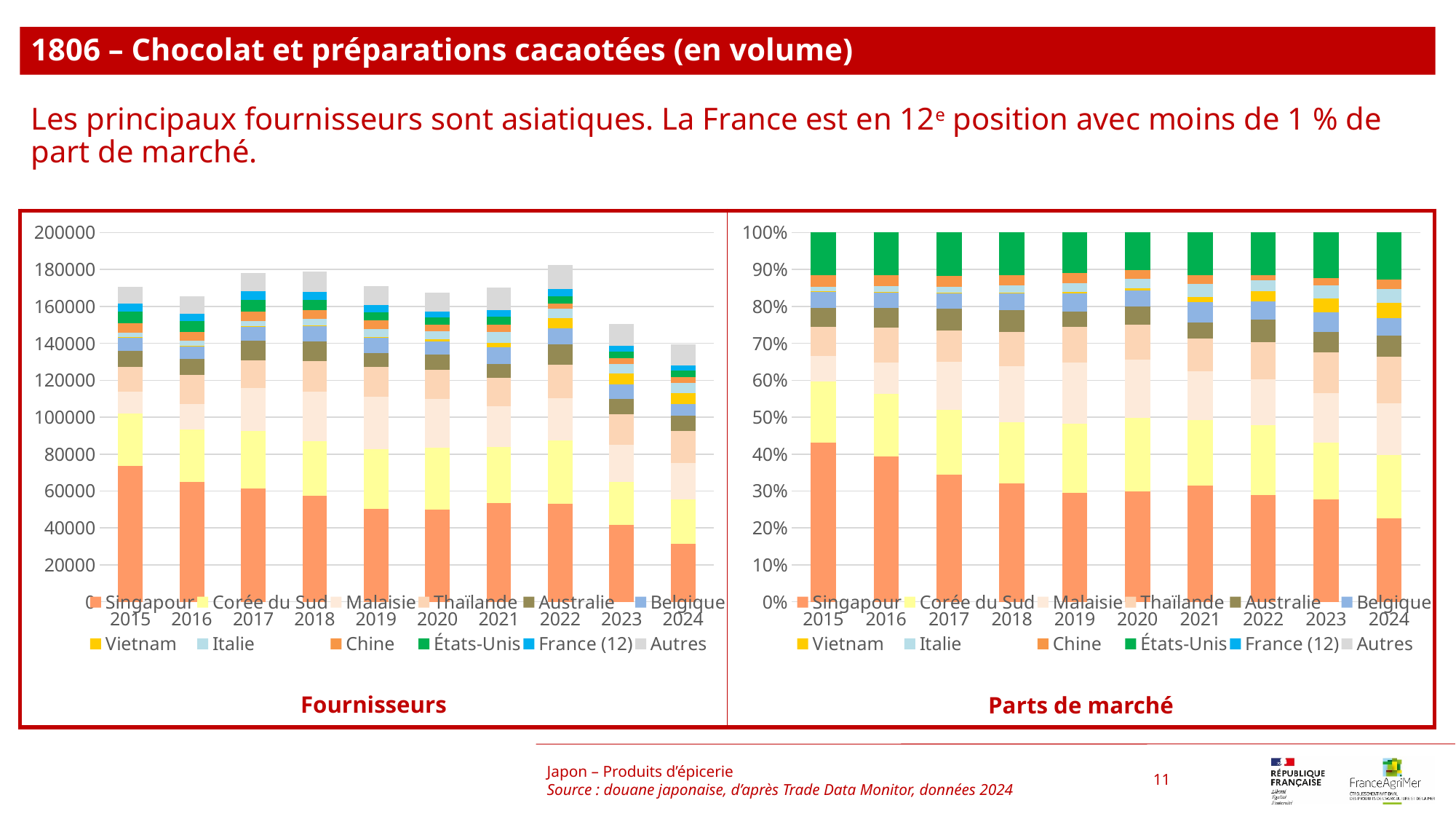
How many years are shown on the x axis of the 'Parts de marché' chart? 10 In the 'Parts de marché' chart, does the Singapour share rise or fall from 2015 to 2024? fall How many series does the legend of the 'Fournisseurs' chart list? 12 In the 'Fournisseurs' chart, is the total of the stacked bar for 2024 greater or less than 160000? less In the 'Fournisseurs' chart, is the value for Singapour in 2024 greater or less than 40000? less What is the title of the chart on the right side of the slide? Parts de marché In the 'Parts de marché' chart, is the share for Singapour in 2015 greater or less than 40%? greater In the 'Fournisseurs' chart, is the Singapour value larger in 2015 or in 2024? 2015 What kind of chart is the 'Fournisseurs' chart on the left? stacked bar chart In the 'Fournisseurs' chart, which year has the lowest total stacked bar? 2024